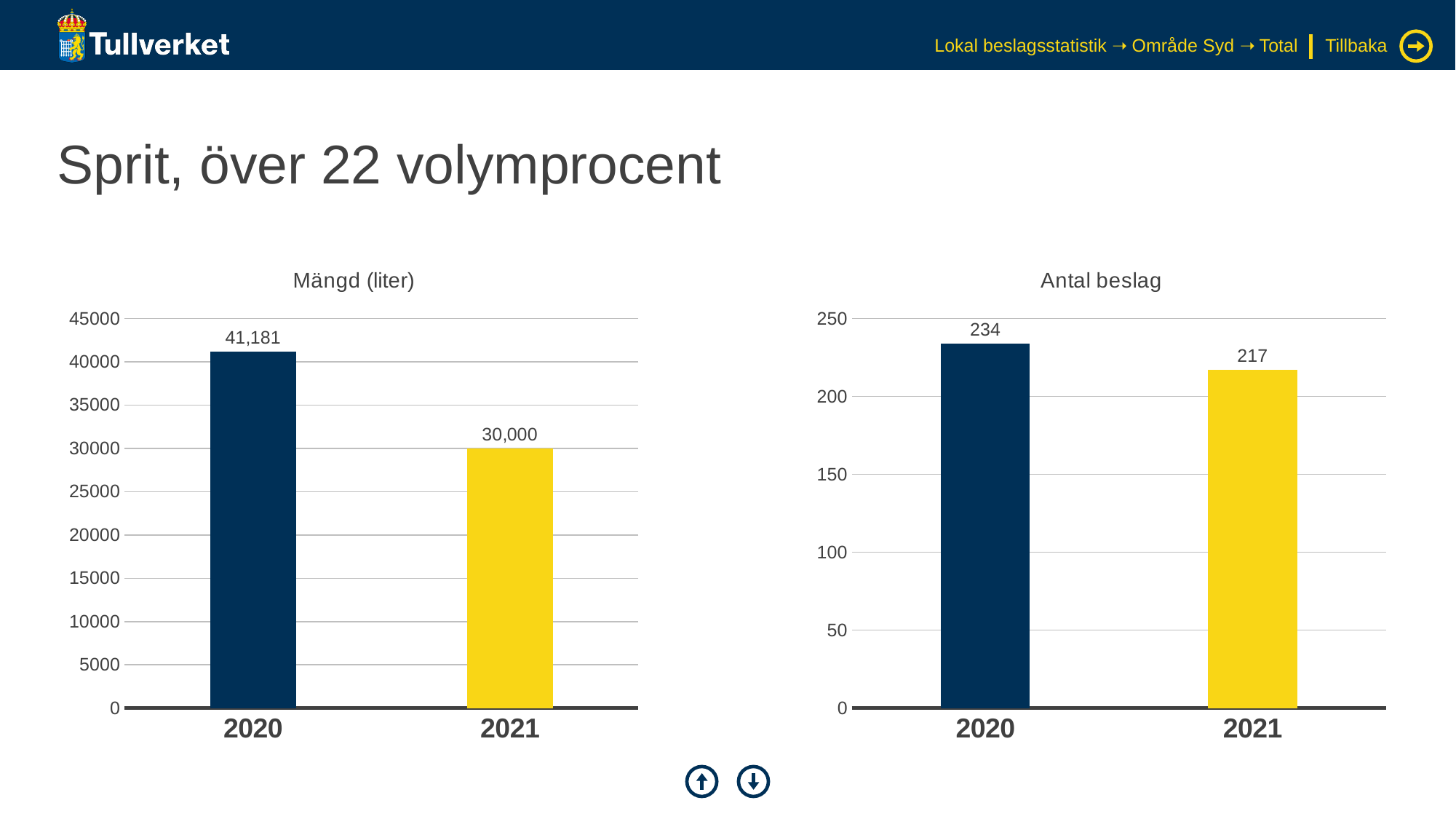
In the 'Mängd (liter)' chart, what is the difference between the 2020 and 2021 values? 11,181 In the 'Antal beslag' chart, what is the difference between the 2020 and 2021 values? 17 In the 'Mängd (liter)' chart, what is the value for 2021? 30,000 In the 'Antal beslag' chart, which year has the lowest value? 2021 In the 'Mängd (liter)' chart, do the values rise or fall from 2020 to 2021? fall In the 'Antal beslag' chart, what is the value for 2021? 217 What kind of chart is the 'Antal beslag' chart? bar chart How many bars are shown in the 'Mängd (liter)' chart? 2 In the 'Antal beslag' chart, is the value for 2021 greater or less than 200? greater In the 'Antal beslag' chart, what is the value for 2020? 234 In the 'Mängd (liter)' chart, what is the value for 2020? 41,181 In the 'Mängd (liter)' chart, which year has the highest value? 2020